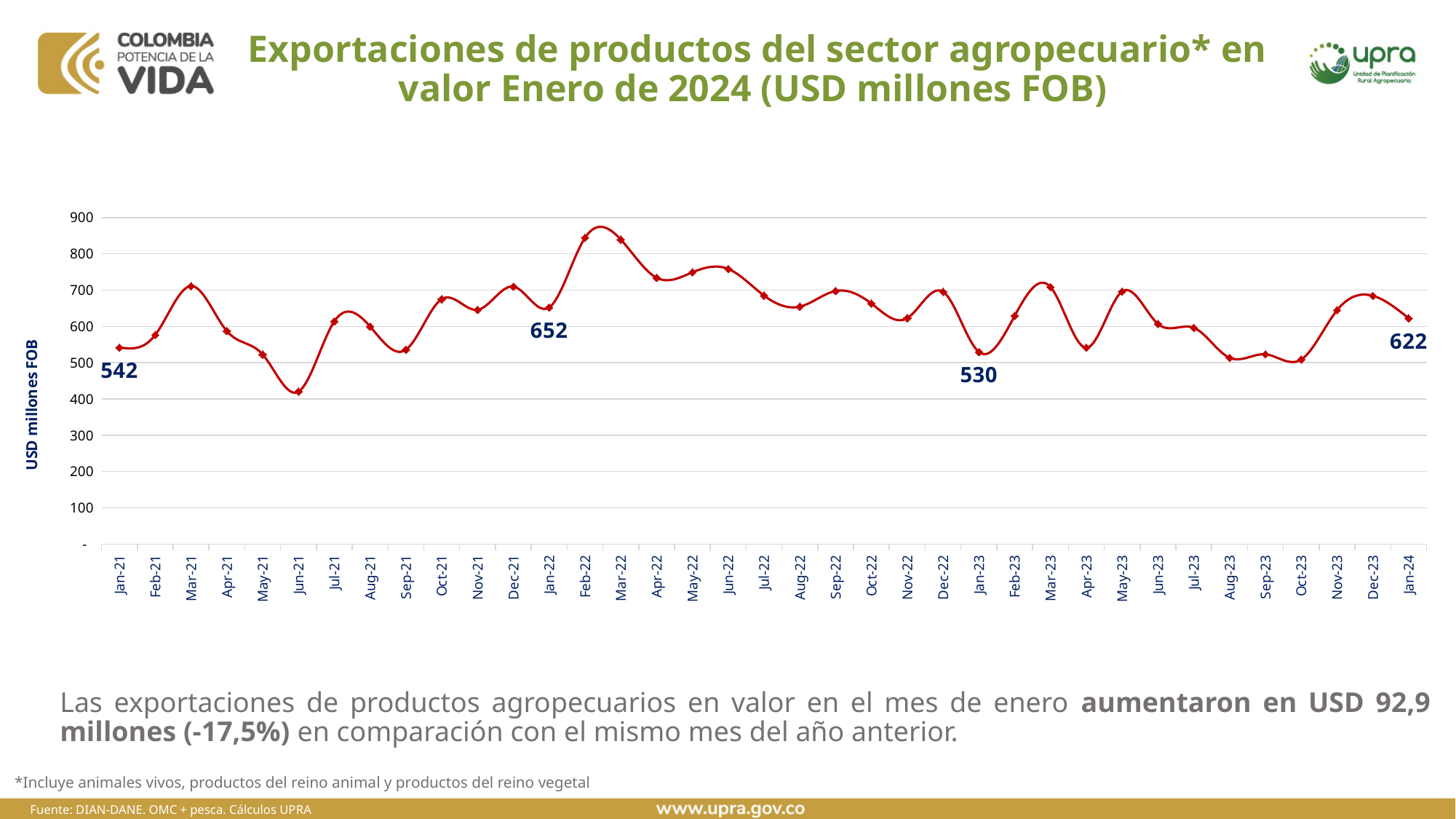
What is the export value for Jan-22? 652 Which is larger, the export value for Jan-22 or for Jan-24? Jan-22 What type of chart is shown on the slide? Line chart What is the export value for Jan-23? 530 Which month has the highest export value on the chart? Feb-22 How many monthly data points are plotted on the chart? 37 What is the label on the vertical axis of the chart? USD millones FOB What is the difference between the export values for Jan-24 and Jan-23? 92 Which month has the lowest export value on the chart? Jun-21 Is the value for Jun-21 greater or less than 500? less What is the export value for Jan-24? 622 What is the export value for Jan-21? 542